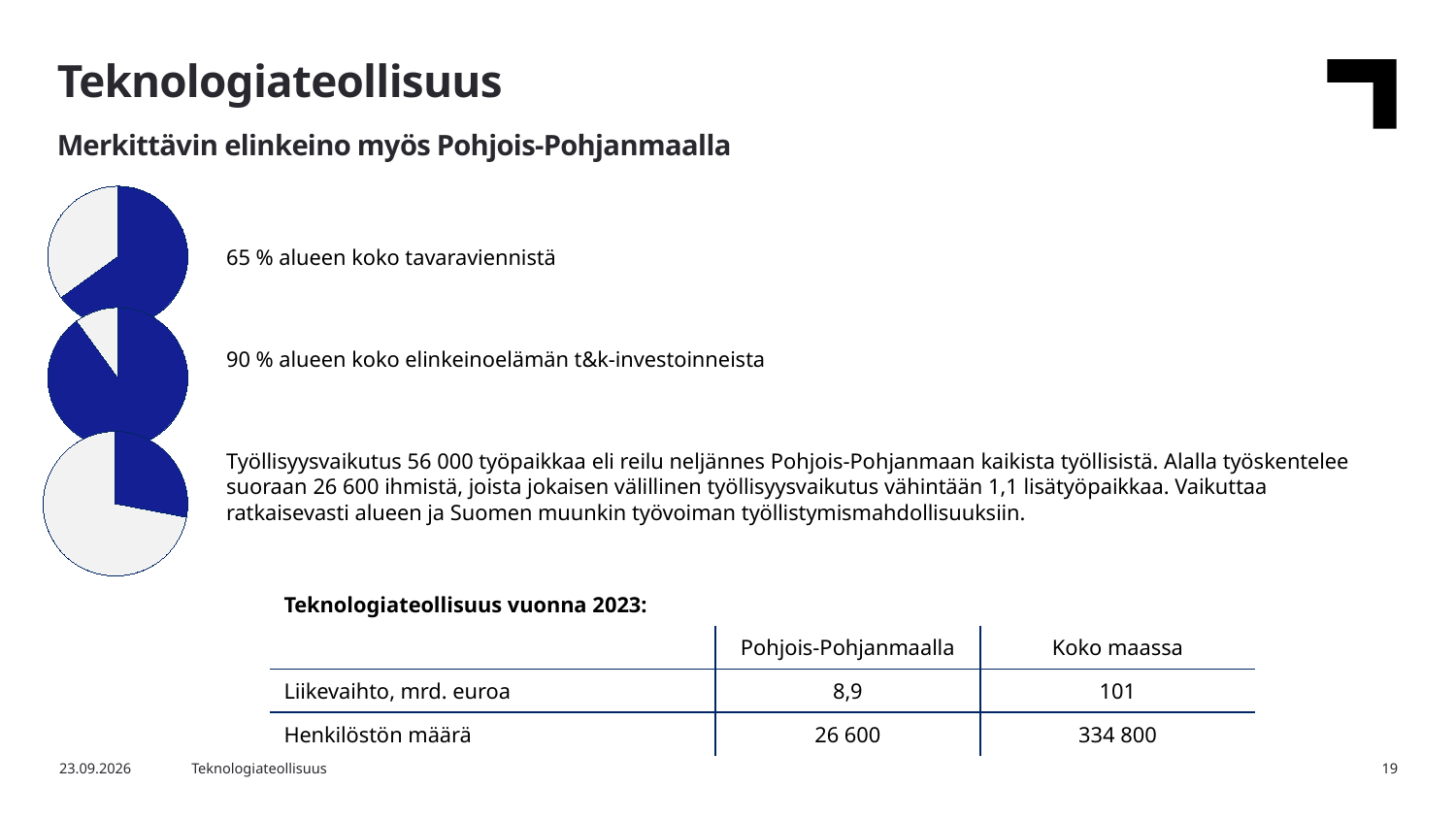
What kind of chart is shown on the left side of the slide? Pie chart What colour is used for the highlighted slice in the pie charts? Blue Is the blue slice in the top pie chart larger or smaller than the blue slice in the bottom pie chart? Larger What does the bottom pie chart represent, according to the text beside it? Employment impact: just over a quarter of all employed people in Pohjois-Pohjanmaa Which of the three pie charts has the smallest blue slice? The bottom one What is the difference between the share shown for the middle pie chart (t&k-investoinnit) and the top pie chart (tavaravienti)? 25 percentage points According to the text next to the middle pie chart, what share of the region's business R&D investments does the technology industry account for? 90 % According to the text next to the top pie chart, what share of the region's total goods exports does the technology industry account for? 65 % Which of the three pie charts has the largest blue slice? The middle one (90 %) How many pie charts are shown on the slide? 3 Is the blue slice in the middle pie chart larger or smaller than the blue slice in the top pie chart? Larger